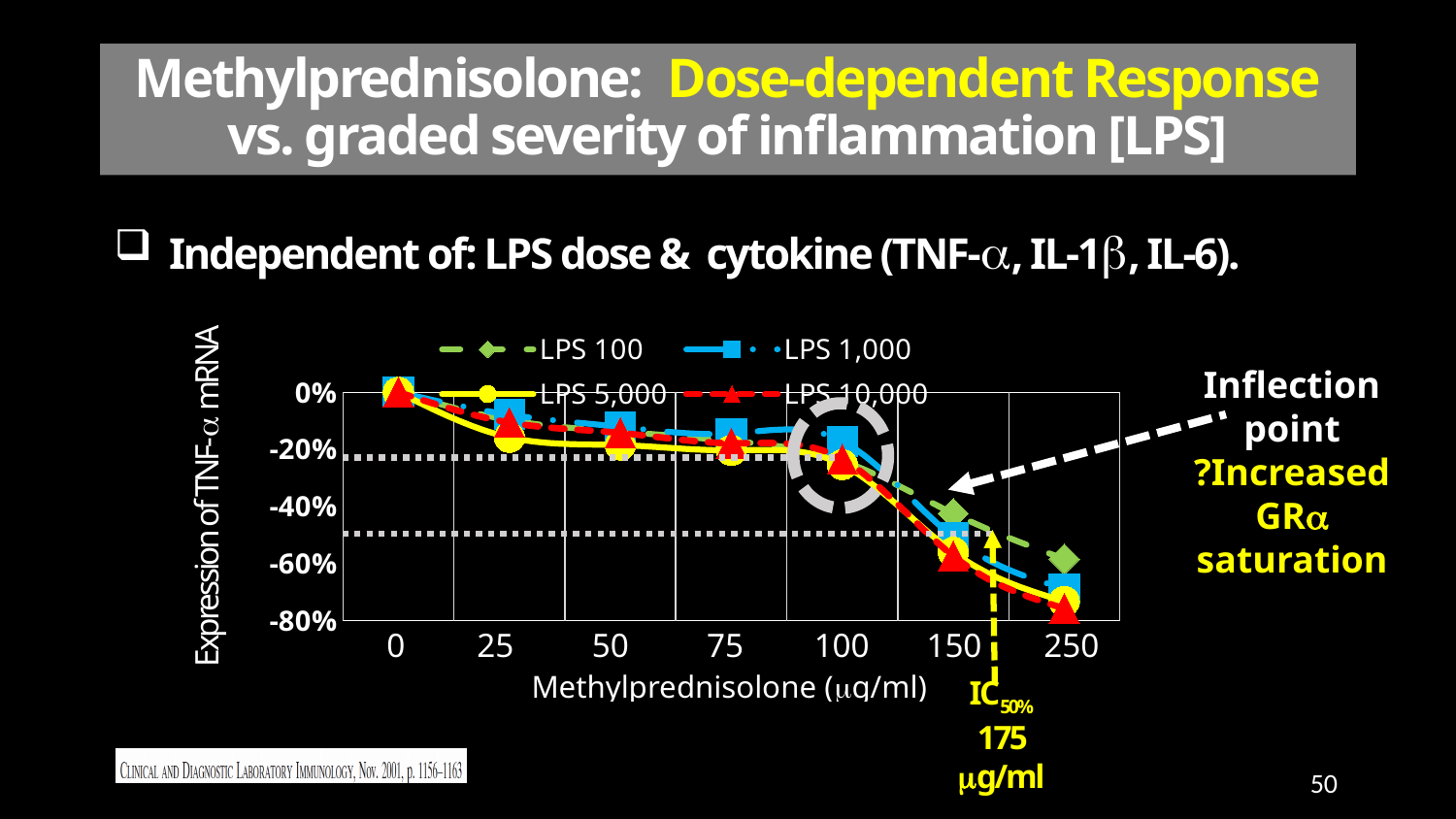
Do the values for LPS 10,000 rise or fall as the methylprednisolone dose increases along the x axis? fall How many series does the chart legend list? 4 Is the value for LPS 10,000 at 250 µg/ml greater or less than -60%? less At 250 µg/ml, which is larger, the value for LPS 100 or the value for LPS 10,000? LPS 100 What is the title of the x axis of the chart? Methylprednisolone (µg/ml) What IC50 value is annotated on the chart? 175 µg/ml What is the value for LPS 100 at a methylprednisolone dose of 0 µg/ml? 0% How many tick values are labelled on the x axis of the chart? 7 Is the value for LPS 100 at 250 µg/ml greater or less than -80%? greater What kind of chart is shown on the slide? line chart At 250 µg/ml, which series has the highest (least negative) value? LPS 100 Is the value for LPS 10,000 at 150 µg/ml greater or less than -40%? less